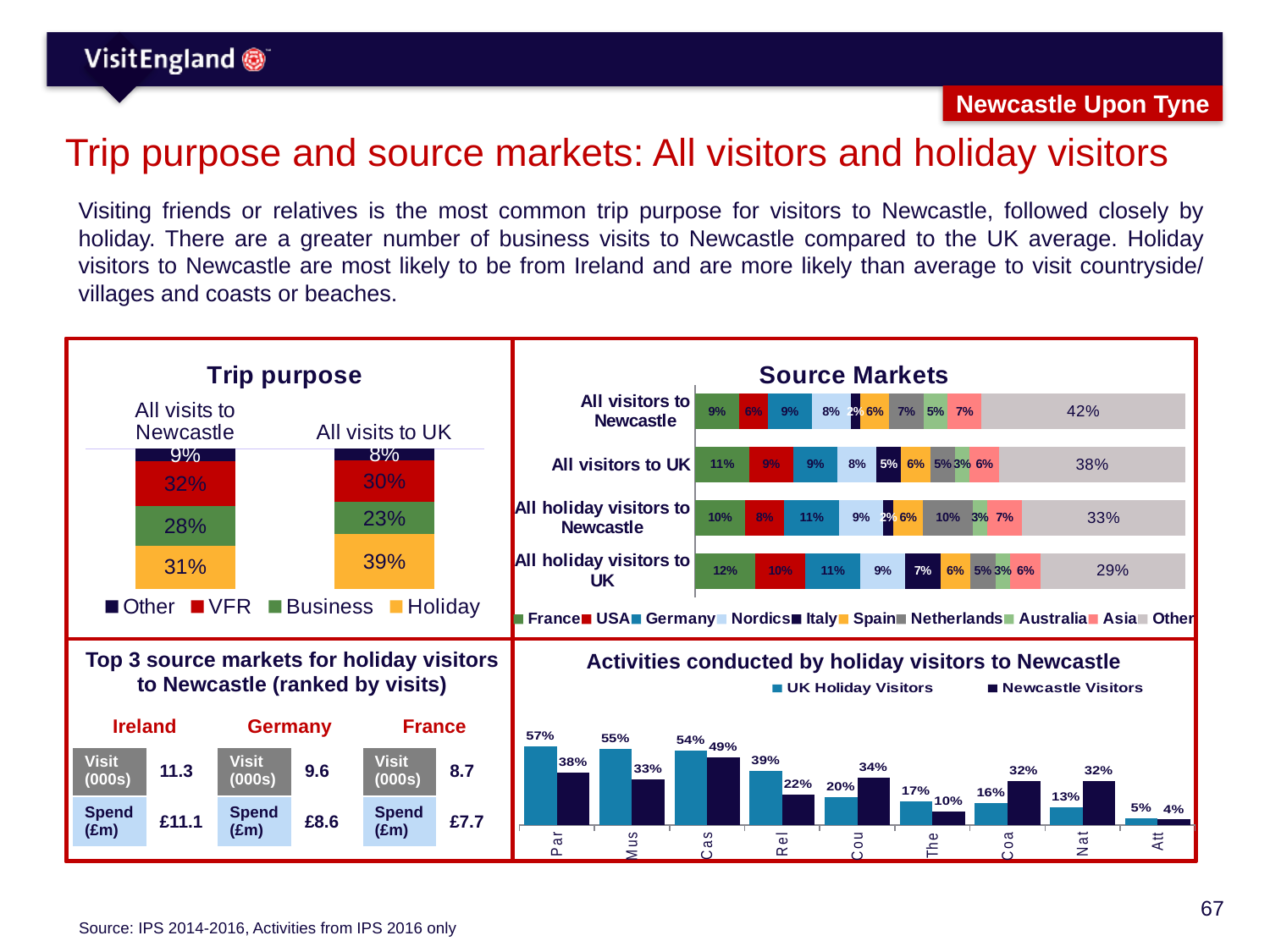
In the Trip purpose chart, what is the difference between the Business share for all visits to Newcastle and for all visits to the UK? 5 percentage points How many series does the legend of the Source Markets chart list? 10 In the Trip purpose chart, what share of all visits to Newcastle are for Holiday? 31% In the Source Markets chart, what share of all holiday visitors to Newcastle come from Germany? 11% In the Activities conducted by holiday visitors to Newcastle chart, what is the value for Newcastle Visitors in the category labelled 'Cas'? 49% In the Activities conducted by holiday visitors to Newcastle chart, which category has the highest value for UK Holiday Visitors? Par In the Trip purpose chart, what share of all visits to the UK are VFR? 30% What kind of chart is the Activities conducted by holiday visitors to Newcastle chart? Bar chart In the Trip purpose chart, which is larger: the Holiday share for all visits to Newcastle or for all visits to the UK? All visits to UK How many categories (bars) are shown in the Source Markets chart? 4 In the Source Markets chart, what share of all visitors to Newcastle come from the Other category? 42% How many series does the legend of the Trip purpose chart list? 4